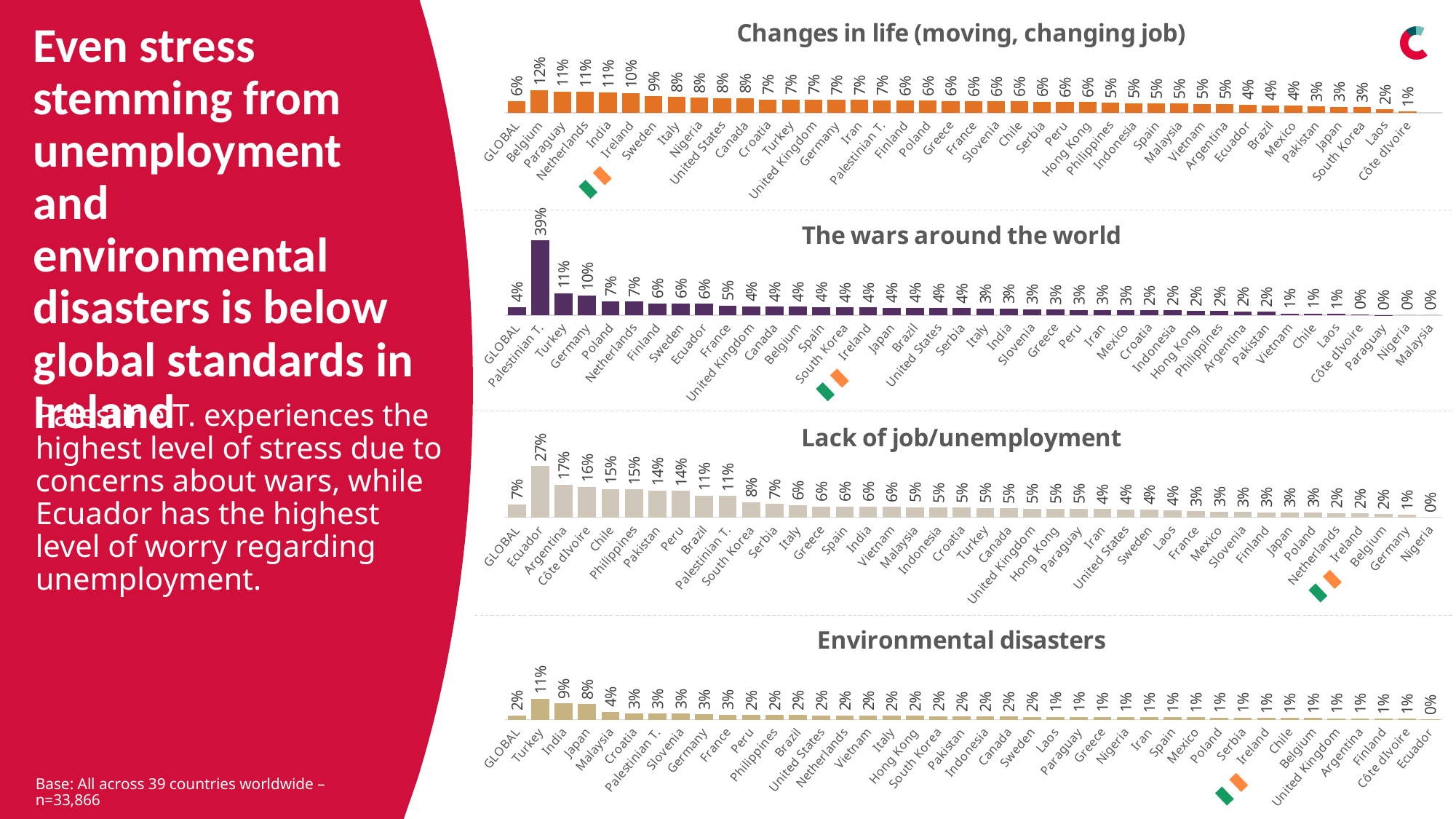
In the 'Lack of job/unemployment' chart, which is larger, Argentina or Chile? Argentina How many bars are plotted in the 'Changes in life (moving, changing job)' chart? 40 In the 'Environmental disasters' chart, what is the difference between India and Japan? 1 percentage point What type of chart is 'The wars around the world'? Bar chart In the 'Changes in life (moving, changing job)' chart, which country has the highest value? Belgium In the 'Changes in life (moving, changing job)' chart, what is the value for Ireland? 10% In 'The wars around the world' chart, what is the value for Palestinian T.? 39% In the 'Lack of job/unemployment' chart, what is the value for Ireland? 2% In the 'Lack of job/unemployment' chart, which country has the highest value? Ecuador In 'The wars around the world' chart, what is the difference between Palestinian T. and Turkey? 28 percentage points In the 'Environmental disasters' chart, what is the value for Turkey? 11% In 'The wars around the world' chart, what is the GLOBAL value? 4%